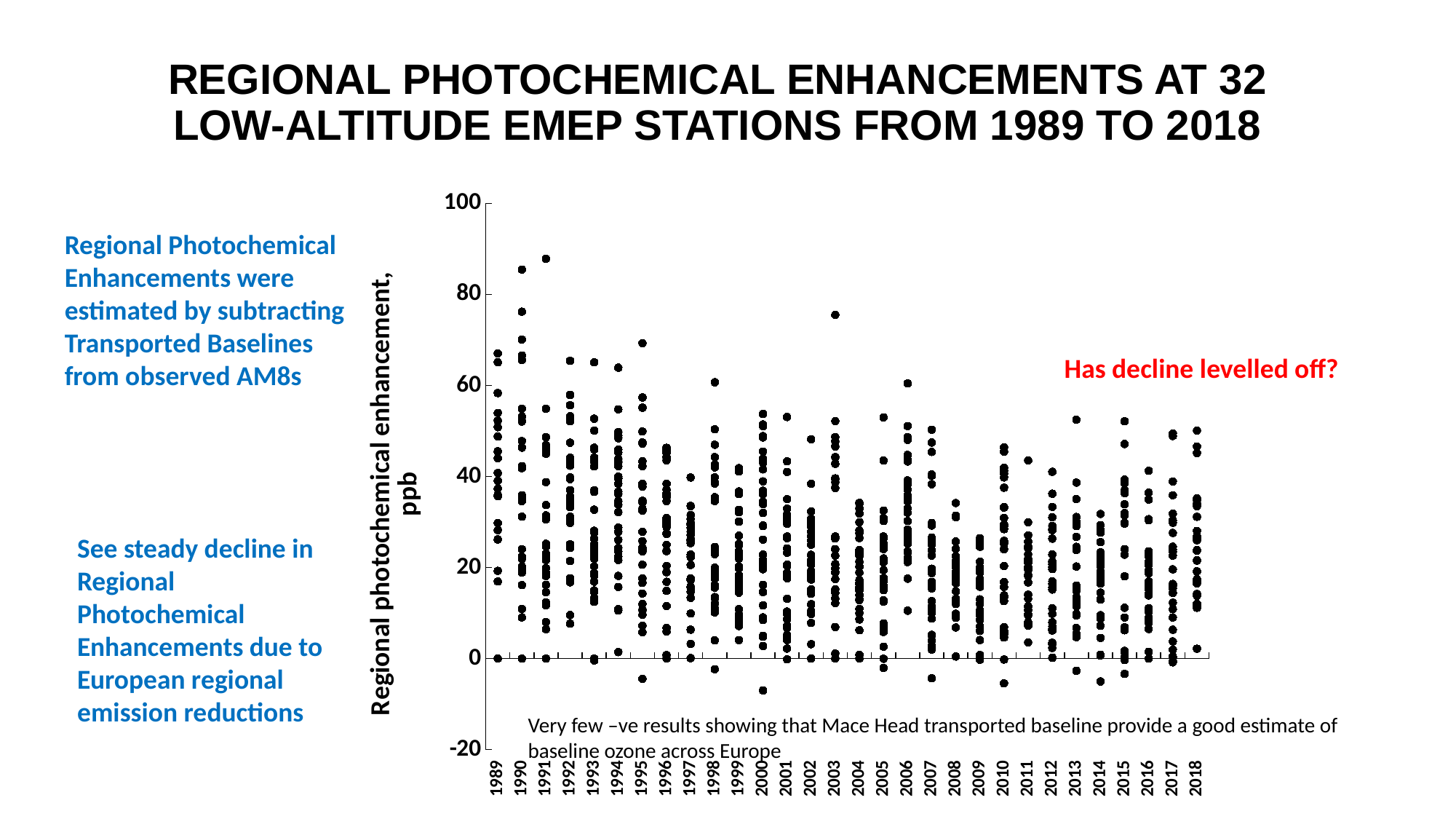
What question is written in red text on the chart? Has decline levelled off? Is the lowest point plotted for 2000 greater or less than 0? less What is the highest value marked on the y axis? 100 Is the highest point plotted for 2009 greater or less than 40? less What is the lowest value marked on the y axis? -20 Is the highest point plotted for 2018 greater or less than 60? less Do the regional photochemical enhancement values generally rise or fall from 1989 to 2018? fall What kind of chart is shown on the slide? scatter chart How many years are shown along the x axis of the chart? 30 What is the label of the y axis? Regional photochemical enhancement, ppb